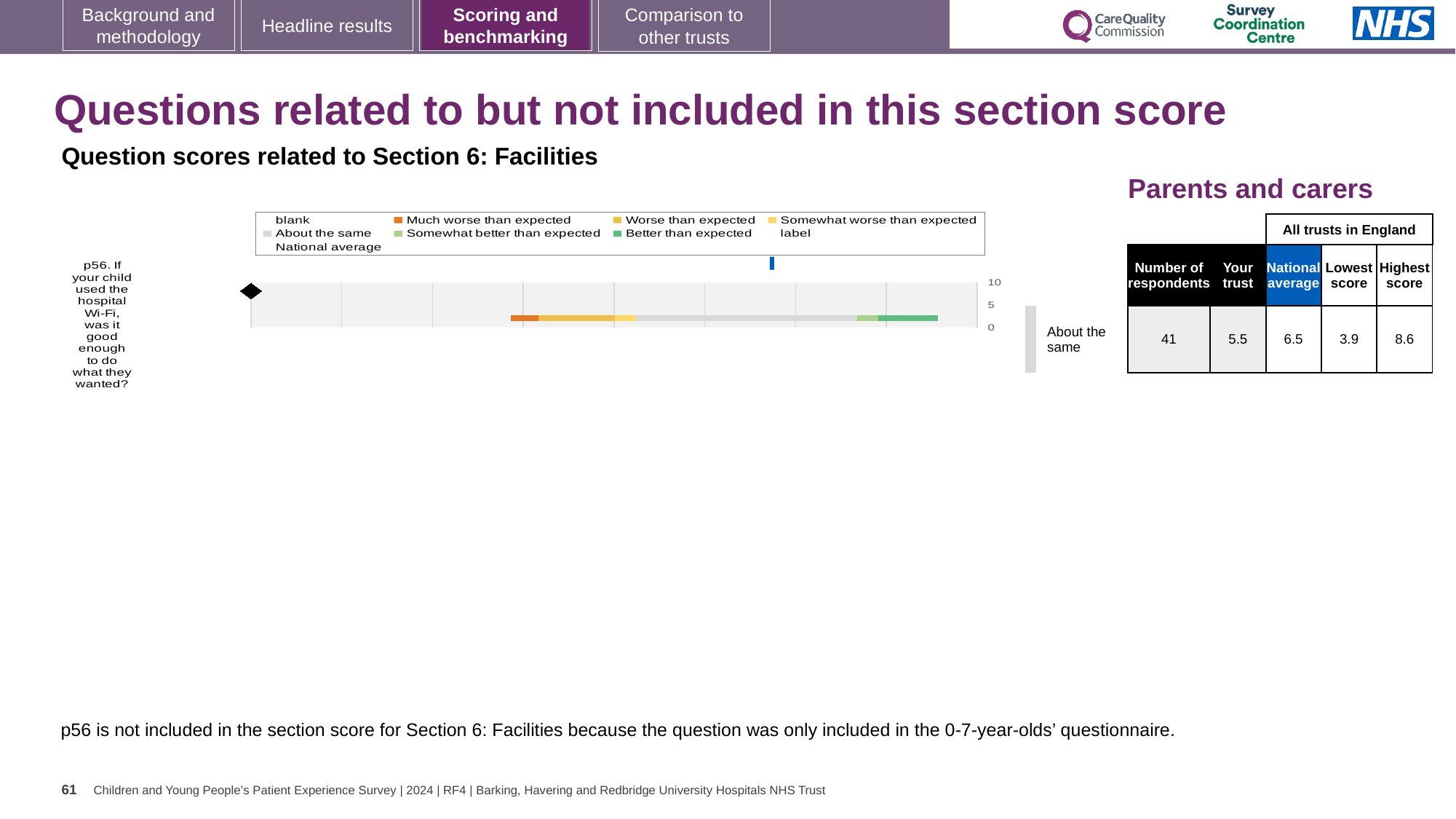
What is the 'Your trust' score for p56 in the table? 5.5 What is the lowest score among all trusts in England for p56? 3.9 How many questions are plotted in the chart? 1 Which is larger for p56, the trust's score or the national average? national average What is the highest score among all trusts in England for p56? 8.6 What colour does the legend use for 'Much worse than expected'? orange What benchmark category is the trust's p56 score placed in? About the same How many respondents answered p56? 41 What is the highest value shown on the chart's axis? 10 What is the national average score for p56? 6.5 What kind of chart is shown on the slide? bar chart What is the difference between the highest and lowest scores for p56 across all trusts in England? 4.7